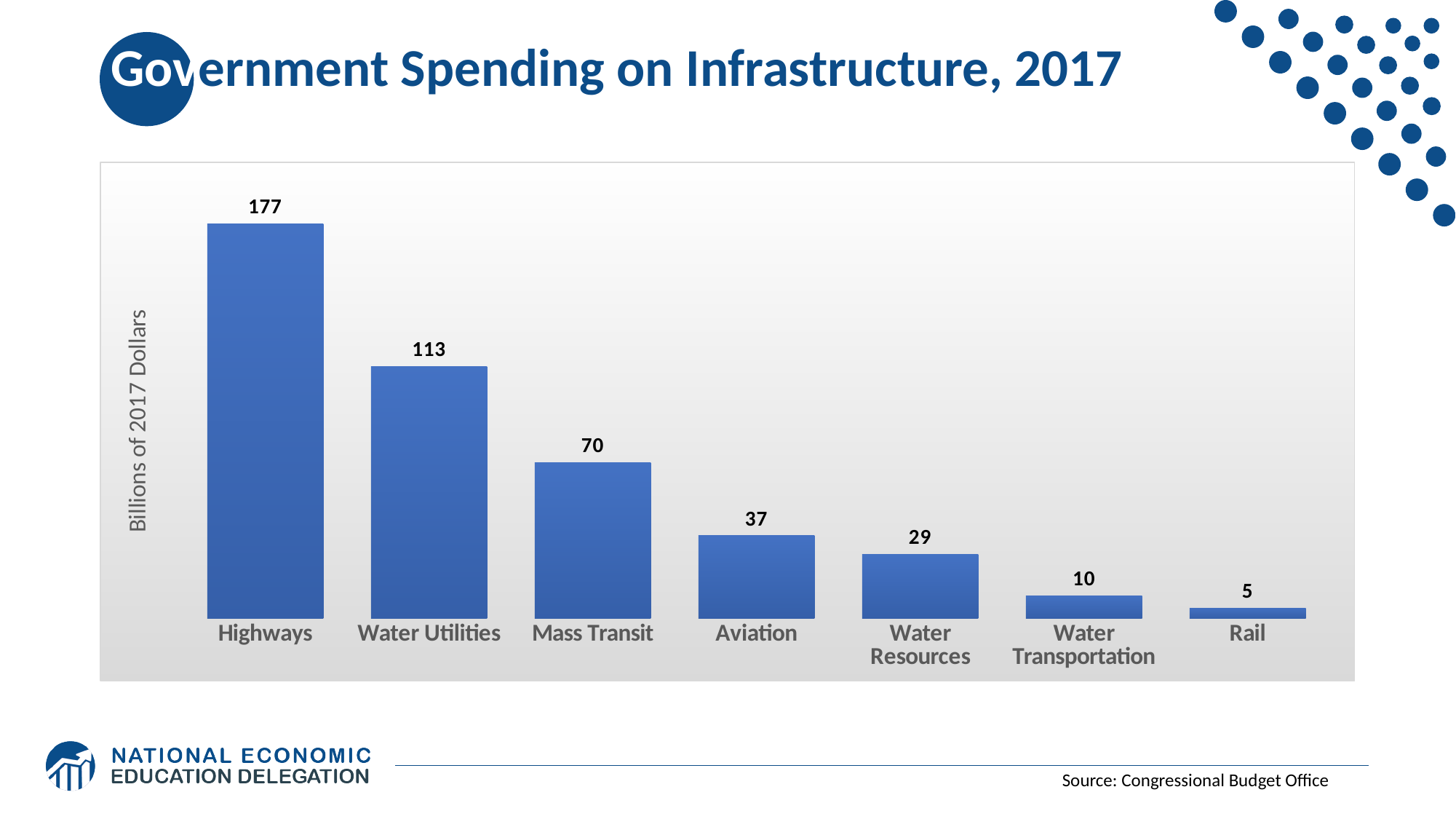
What is the label on the vertical axis of the chart? Billions of 2017 Dollars Which category has the highest value? Highways What is the difference between the values for Mass Transit and Aviation? 33 Which is larger, the value for Water Resources or the value for Water Transportation? Water Resources How many categories are shown in the chart? 7 Which category has the lowest value? Rail What is the value for Highways? 177 What is the value for Aviation? 37 What kind of chart is shown on the slide? Bar chart What is the value for Water Utilities? 113 What is the difference between the values for Highways and Water Utilities? 64 What is the value for Rail? 5